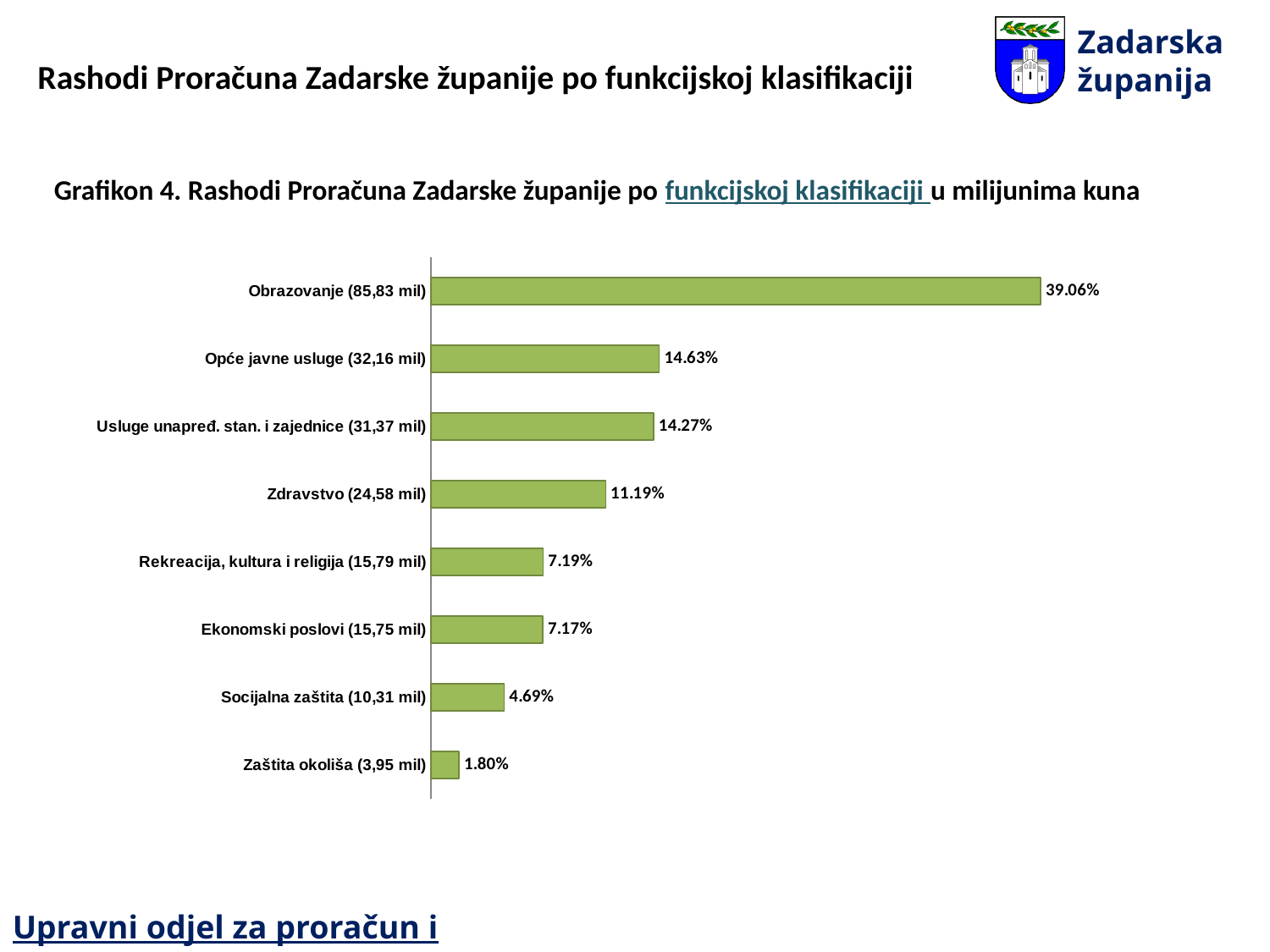
What percentage is shown for Socijalna zaštita (10,31 mil)? 4.69% What colour are the bars in the chart? Green Which category has the highest share of expenditures? Obrazovanje (85,83 mil) Which category has the lowest share of expenditures? Zaštita okoliša (3,95 mil) What is the difference in percentage points between Zdravstvo (24,58 mil) and Socijalna zaštita (10,31 mil)? 6.50% How many categories are shown in the chart? 8 Which has a larger share, Zdravstvo (24,58 mil) or Socijalna zaštita (10,31 mil)? Zdravstvo (24,58 mil) What percentage is shown for Obrazovanje (85,83 mil)? 39.06% What percentage is shown for Zdravstvo (24,58 mil)? 11.19% What type of chart is shown on the slide? Bar chart What is the difference in percentage points between Obrazovanje (85,83 mil) and Opće javne usluge (32,16 mil)? 24.43% What percentage is shown for Usluge unapređ. stan. i zajednice (31,37 mil)? 14.27%